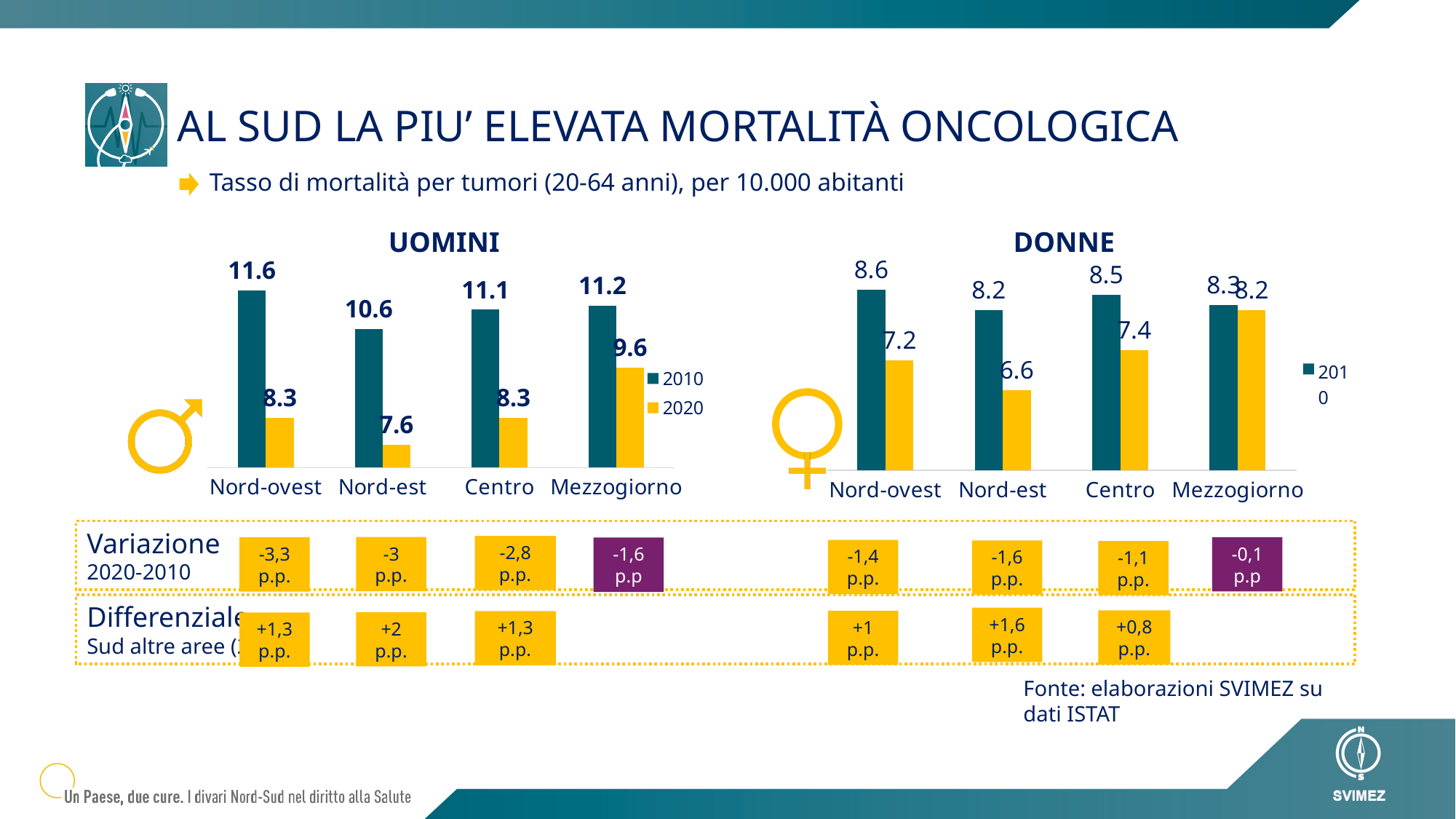
In the UOMINI chart, what is the 2010 value for Nord-ovest? 11.6 In the DONNE chart, which is larger: the 2020 value for Mezzogiorno or the 2020 value for Centro? Mezzogiorno In the DONNE chart, which category has the lowest 2020 value? Nord-est In the UOMINI chart, what is the difference between the 2010 and 2020 values for Nord-est? 3 How many categories are shown on the x axis of the DONNE chart? 4 In the UOMINI chart, what is the 2020 value for Mezzogiorno? 9.6 In the DONNE chart, what is the 2020 value for Nord-est? 6.6 In the DONNE chart, what is the 2010 value for Centro? 8.5 In the UOMINI chart, which category has the highest 2020 value? Mezzogiorno How many series does the legend of the UOMINI chart list? 2 What type of chart is the UOMINI chart? Bar chart In the UOMINI chart, which category has the lowest 2010 value? Nord-est